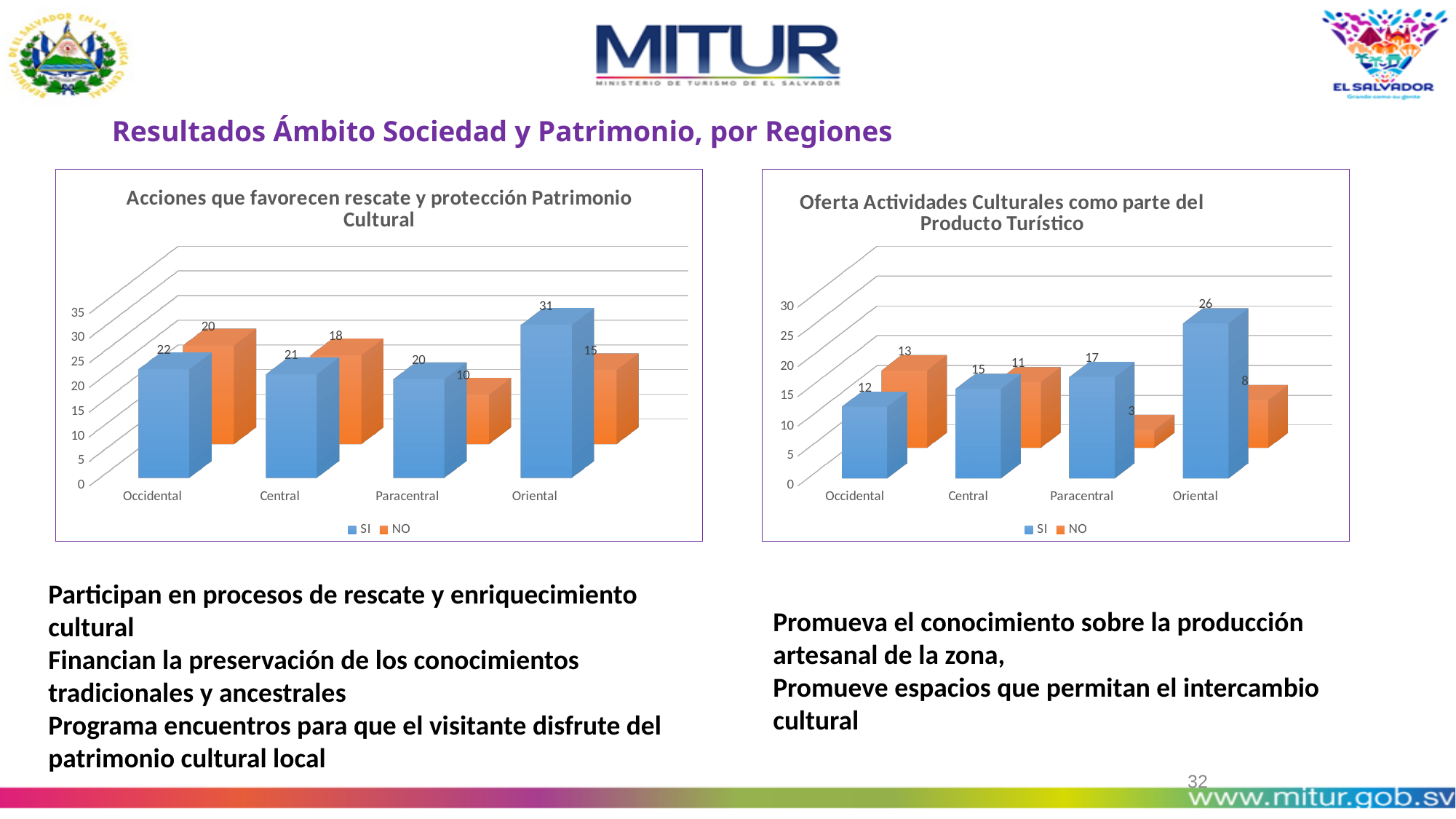
In the chart 'Oferta Actividades Culturales como parte del Producto Turístico', what is the difference between the SI and NO values for Oriental? 18 In the chart 'Acciones que favorecen rescate y protección Patrimonio Cultural', what is the NO value for Paracentral? 10 In the chart 'Acciones que favorecen rescate y protección Patrimonio Cultural', what colour represents the NO series? Orange In the chart 'Acciones que favorecen rescate y protección Patrimonio Cultural', which region has the highest SI value? Oriental In the chart 'Acciones que favorecen rescate y protección Patrimonio Cultural', what is the SI value for Oriental? 31 In the chart 'Oferta Actividades Culturales como parte del Producto Turístico', which region has the lowest NO value? Paracentral In the chart 'Acciones que favorecen rescate y protección Patrimonio Cultural', how many regions are shown on the x axis? 4 In the chart 'Oferta Actividades Culturales como parte del Producto Turístico', is the SI value for Occidental larger or smaller than the NO value for Occidental? smaller In the chart 'Oferta Actividades Culturales como parte del Producto Turístico', what is the SI value for Paracentral? 17 What type of chart is 'Oferta Actividades Culturales como parte del Producto Turístico'? Bar chart In the chart 'Oferta Actividades Culturales como parte del Producto Turístico', how many series does the legend list? 2 In the chart 'Acciones que favorecen rescate y protección Patrimonio Cultural', what is the difference between the SI and NO values for Oriental? 16